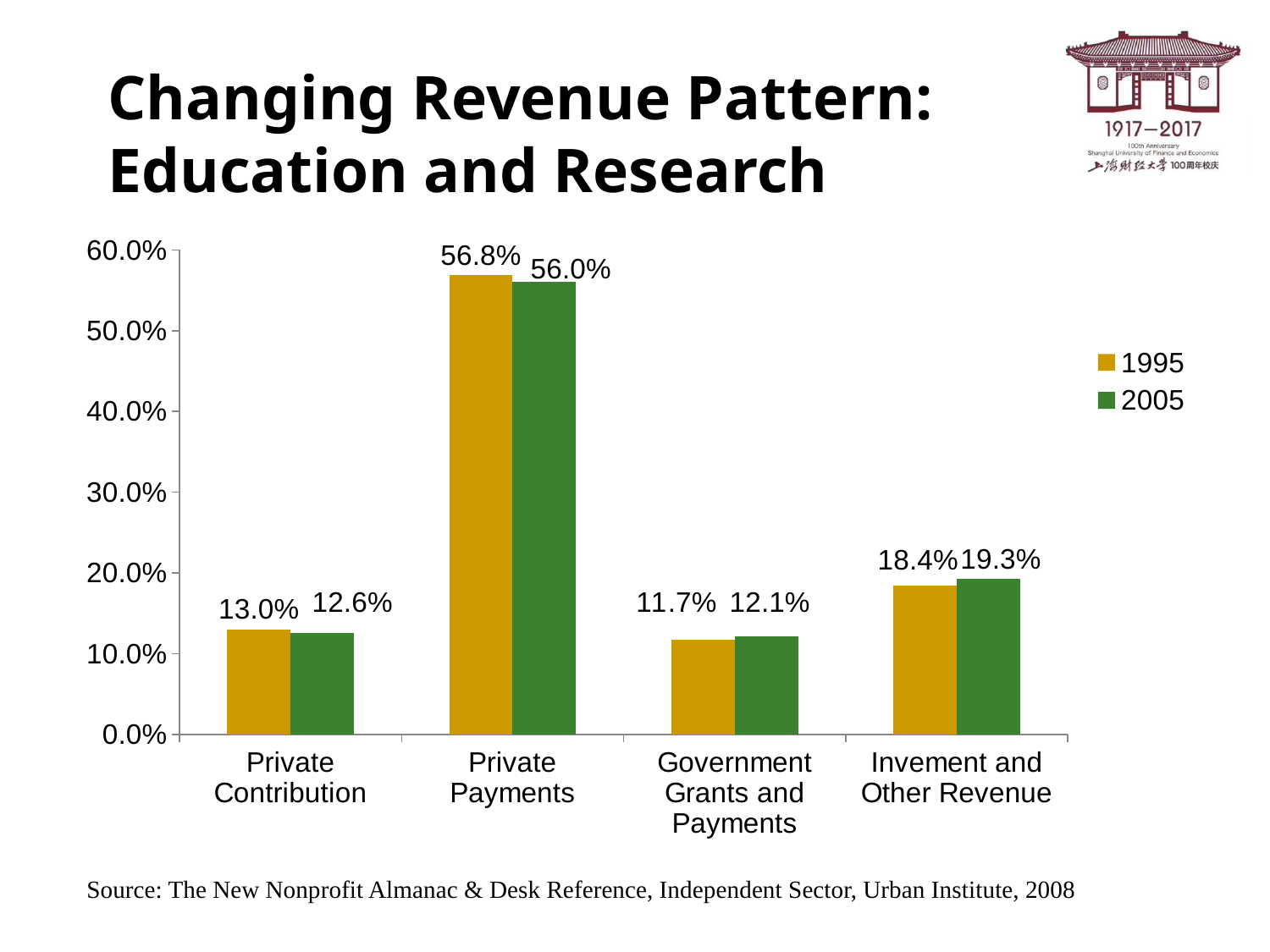
How many categories are shown on the x axis? 4 What kind of chart is shown on the slide? Bar chart How many series does the legend list? 2 What is the value for Government Grants and Payments in 2005? 12.1% What is the value for Private Contribution in 2005? 12.6% Which category has the highest value for 2005? Private Payments Which series is shown in green in the legend? 2005 What is the value for Invement and Other Revenue in 1995? 18.4% What is the value for Private Payments in 1995? 56.8% Which is larger for Invement and Other Revenue, the 1995 value or the 2005 value? 2005 What is the difference between the 1995 and 2005 values for Private Payments? 0.8% Which category has the lowest value for 1995? Government Grants and Payments